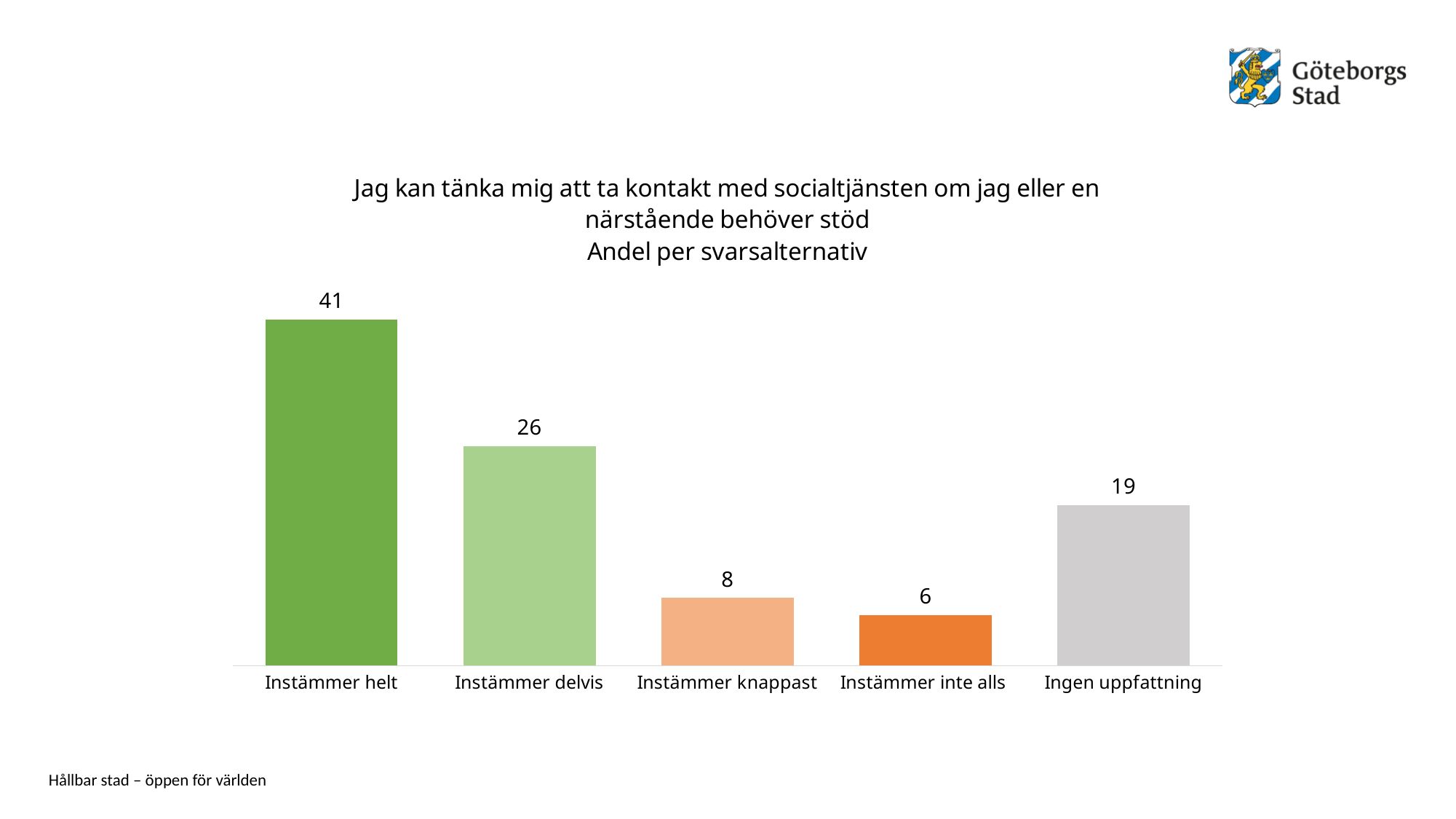
Which category has the highest value? Instämmer helt How many categories are shown on the x axis? 5 Which is larger, the value for "Ingen uppfattning" or the value for "Instämmer knappast"? Ingen uppfattning Which category has the lowest value? Instämmer inte alls What is the value for "Instämmer knappast"? 8 What is the value for "Instämmer inte alls"? 6 What kind of chart is shown on the slide? Bar chart What is the value for "Instämmer helt"? 41 What is the difference between the values for "Instämmer helt" and "Instämmer delvis"? 15 What is the last line of the chart title? Andel per svarsalternativ What is the value for "Ingen uppfattning"? 19 What is the value for "Instämmer delvis"? 26